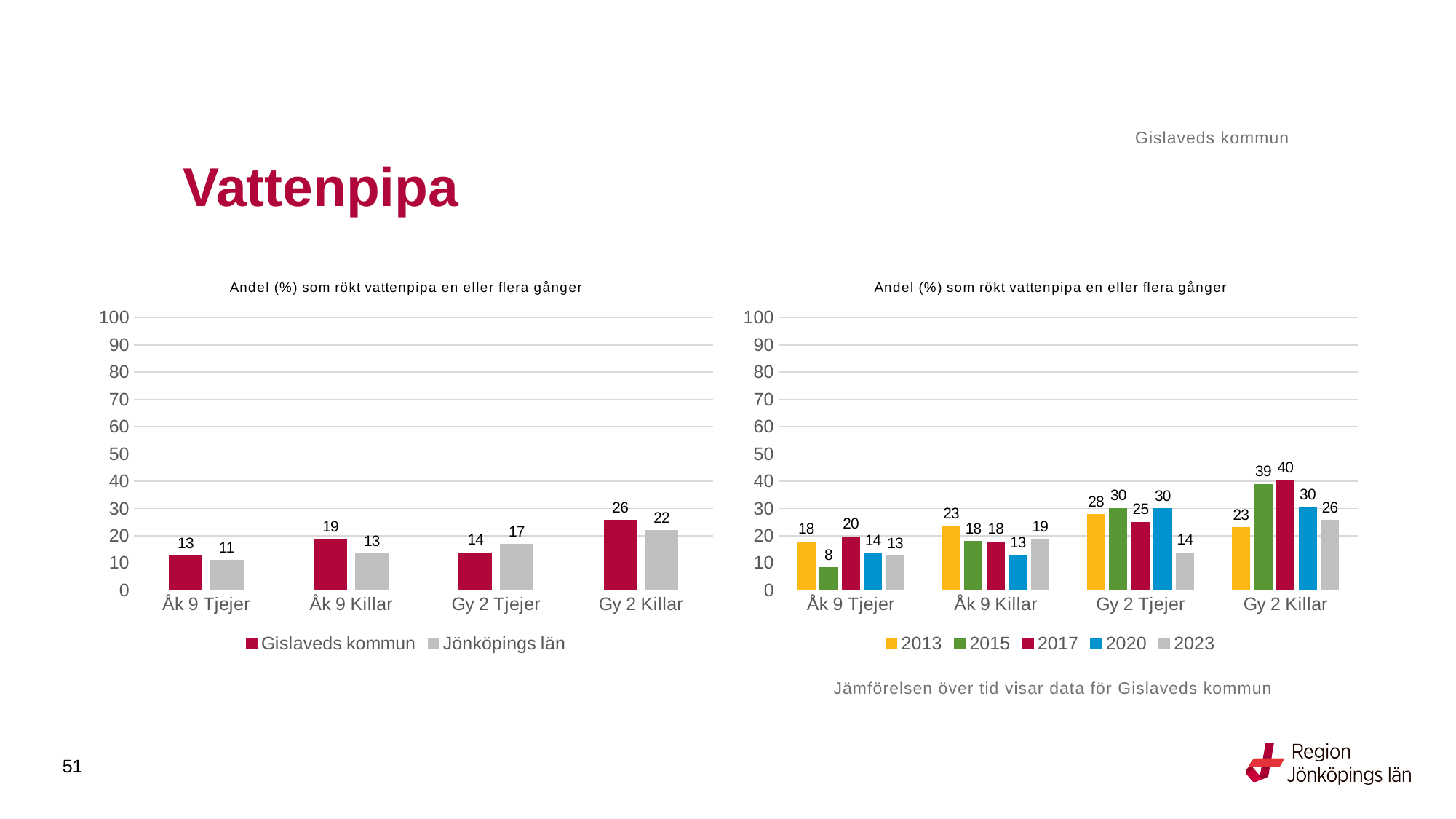
How many series does the legend of the left chart list? 2 In the right chart, what is the value for 2017 for Gy 2 Killar? 40 In the left chart, which category has the highest value for Gislaveds kommun? Gy 2 Killar How many series does the legend of the right chart list? 5 In the right chart, which year has the lowest value for Gy 2 Tjejer? 2023 In the left chart, which is larger for Gy 2 Tjejer: Gislaveds kommun or Jönköpings län? Jönköpings län In the right chart, what is the difference between 2013 and 2023 for Åk 9 Killar? 4 What kind of chart is the right chart? Bar chart In the left chart, what is the value for Gislaveds kommun for Gy 2 Killar? 26 In the left chart, what is the difference between Gislaveds kommun and Jönköpings län for Åk 9 Killar? 6 In the left chart, what is the value for Jönköpings län for Åk 9 Tjejer? 11 In the right chart, what is the value for 2015 for Åk 9 Tjejer? 8